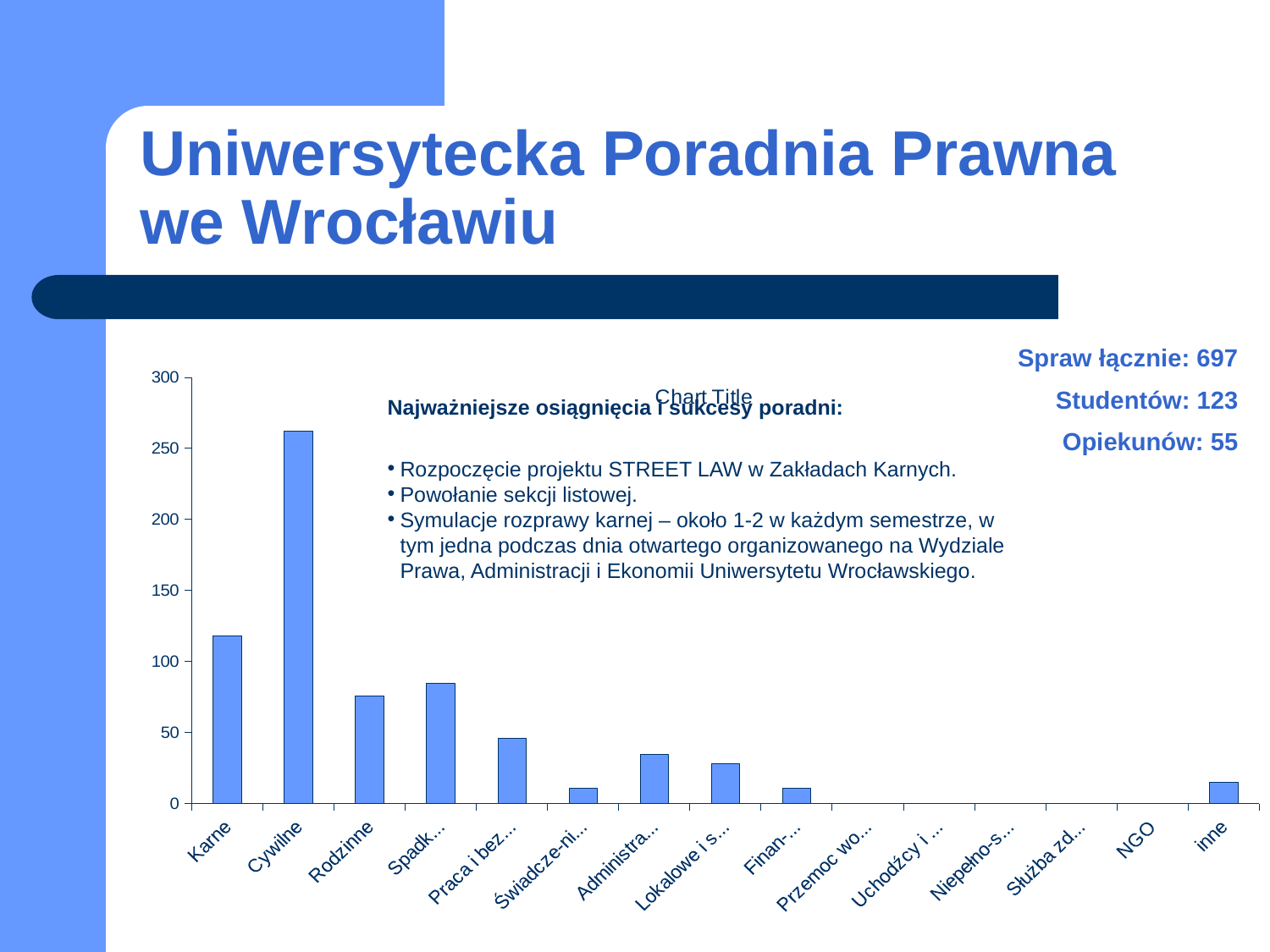
Is the value for Administra... greater or less than 50? less Which category has the highest bar in the chart? Cywilne Is the value for Cywilne greater or less than 250? greater Is the value for Karne greater or less than 100? greater How many categories are shown on the x axis of the chart? 15 What kind of chart is shown on the slide? bar chart Which is larger, the value for inne or the value for NGO? inne Which is larger, the value for Karne or the value for Rodzinne? Karne Which is larger, the value for Cywilne or the value for Karne? Cywilne What title is displayed above the chart? Chart Title